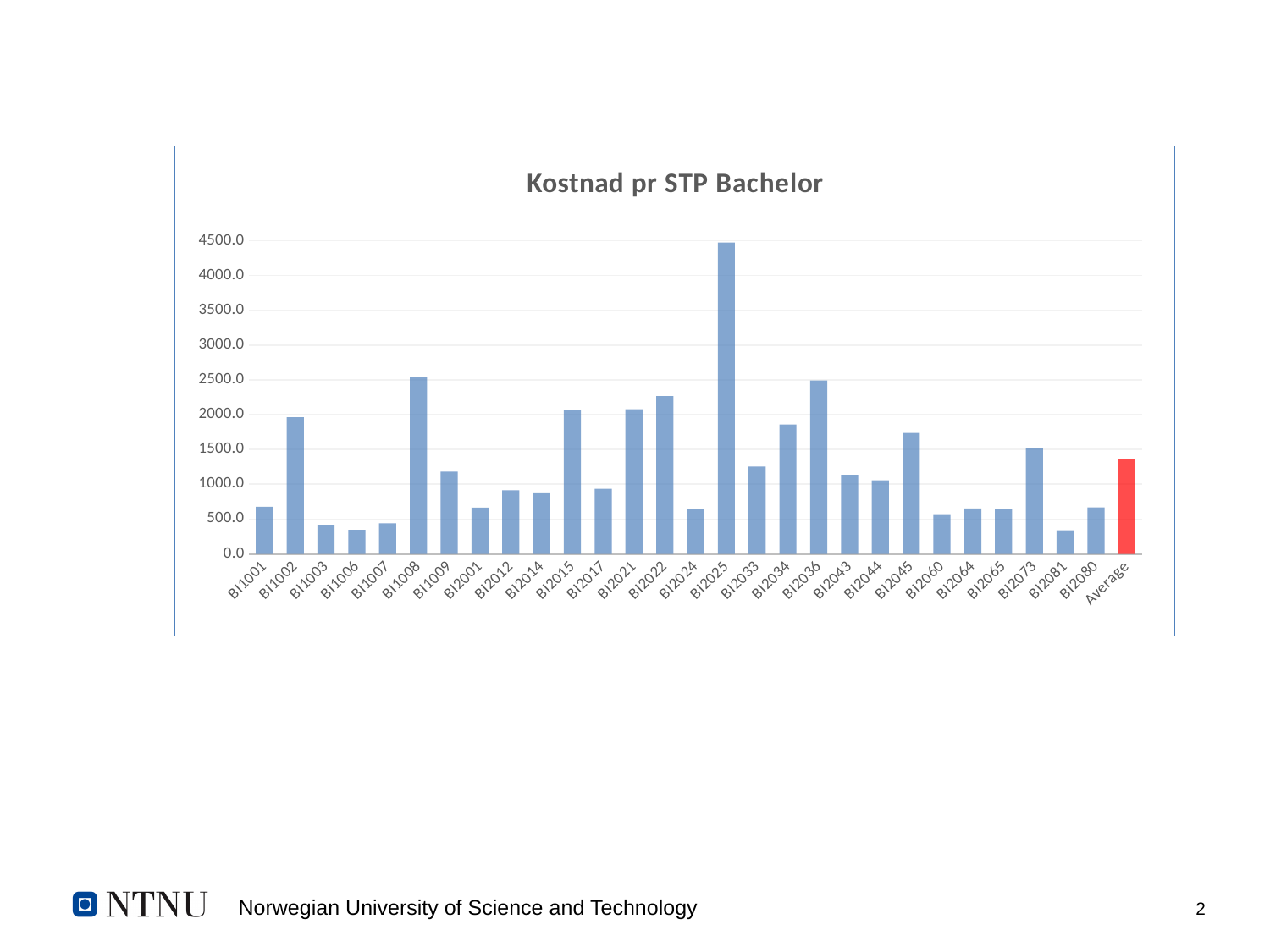
How many bars (categories) are plotted in the chart, including Average? 29 What is the title of the chart? Kostnad pr STP Bachelor Is the value for BI1008 greater or less than 2000? greater Is the value for BI2025 greater or less than 4000? greater Which has a larger value, BI2025 or BI2036? BI2025 Which has a larger value, BI1002 or BI1003? BI1002 What kind of chart is shown on the slide? bar chart Is the value for Average greater or less than 1500? less Which bar in the chart is coloured red instead of blue? Average Which category has the highest value in the chart? BI2025